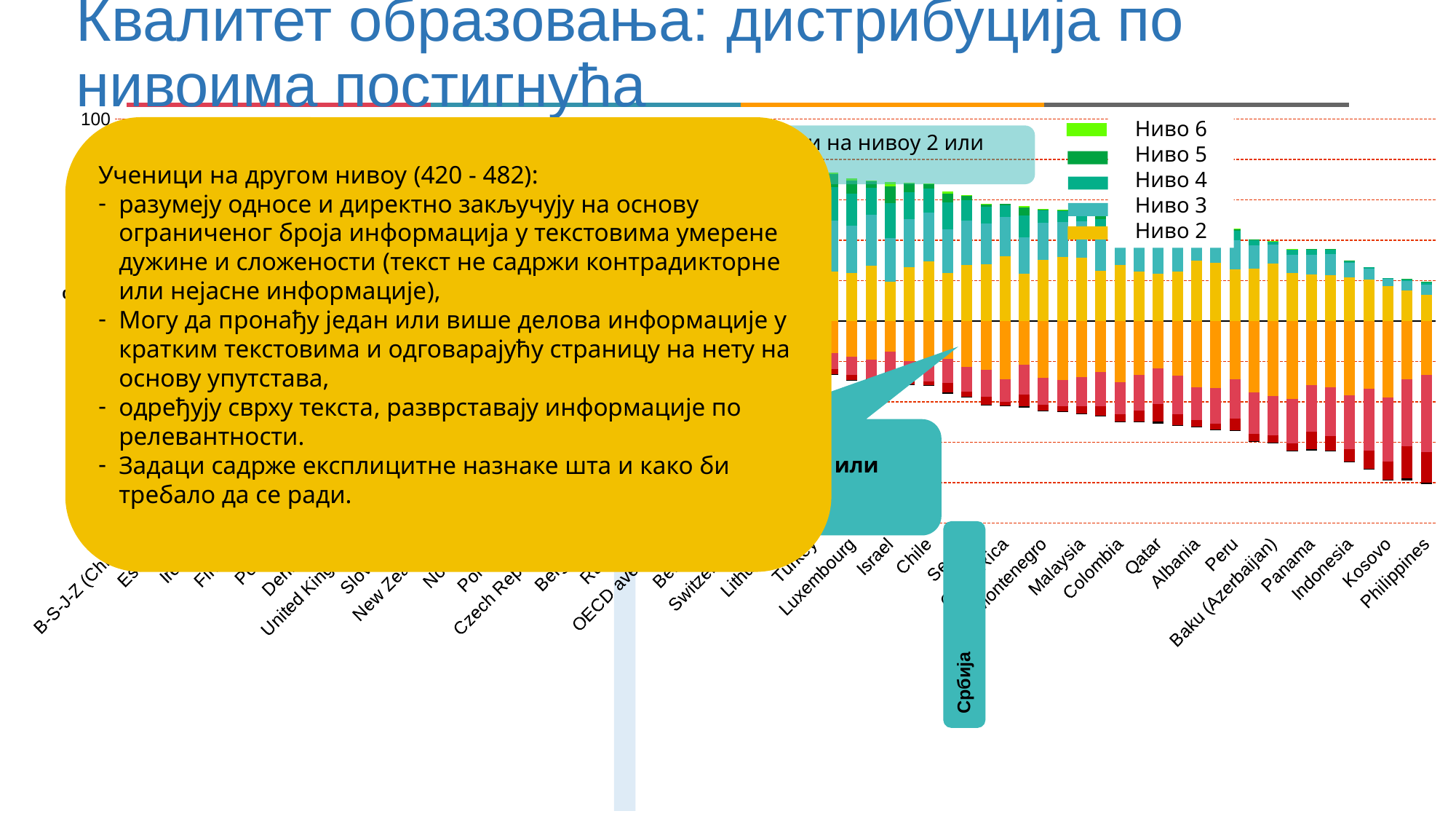
What colour represents the series "Ниво 2" in the chart? yellow/orange Moving from left to right along the x axis, do the stacked bars below the zero line get larger or smaller? larger Which has a larger stacked bar below the zero line, Kosovo or Israel? Kosovo What kind of chart is shown on the slide? stacked bar chart Which country is the rightmost category on the x axis of the chart? Philippines Moving from left to right along the x axis, do the stacked bars above the zero line get taller or shorter? shorter Which legend entry is listed first (at the top) in the chart's legend? Ниво 6 What is the highest value printed on the vertical axis of the chart? 100 Which category is the leftmost on the x axis of the chart? B-S-J-Z (China) Which has a taller stacked bar above the zero line, Luxembourg or Philippines? Luxembourg Which country is singled out with a vertical "Србија" marker on the chart? Serbia